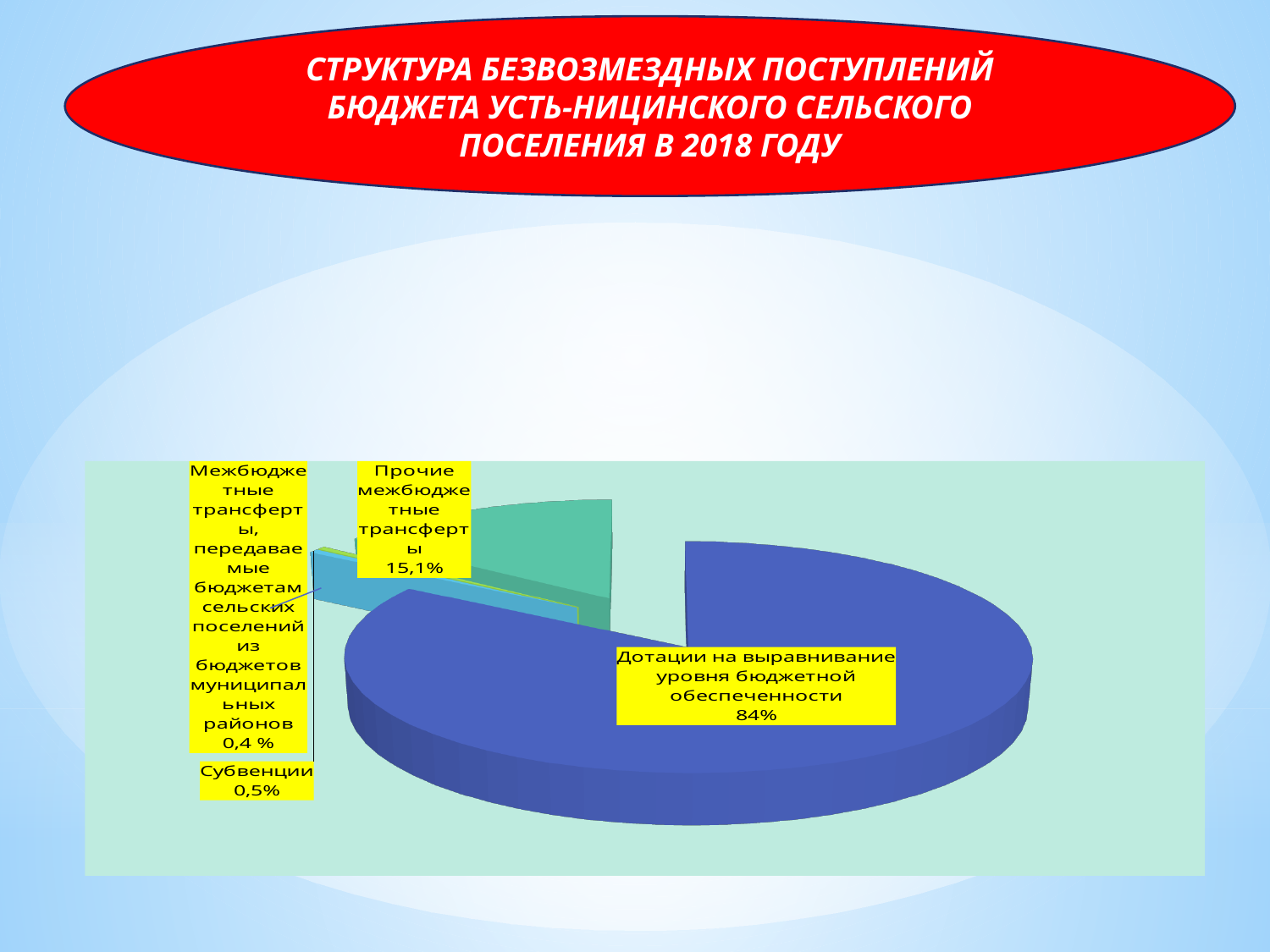
What kind of chart is shown on the slide? pie chart How many slices does the pie chart have? 4 What share of the pie is labelled "Субвенции"? 0,5% What is the difference in percentage points between "Дотации на выравнивание уровня бюджетной обеспеченности" and "Прочие межбюджетные трансферты"? 68,9 What share of the pie is labelled "Дотации на выравнивание уровня бюджетной обеспеченности"? 84% What year does the chart title refer to? 2018 Which slice of the pie is the largest? Дотации на выравнивание уровня бюджетной обеспеченности What share of the pie is labelled "Межбюджетные трансферты, передаваемые бюджетам сельских поселений из бюджетов муниципальных районов"? 0,4 % Which is larger, the share for "Субвенции" or the share for "Прочие межбюджетные трансферты"? Прочие межбюджетные трансферты What colour is the largest slice of the pie? blue What share of the pie is labelled "Прочие межбюджетные трансферты"? 15,1% Which slice of the pie is the smallest? Межбюджетные трансферты, передаваемые бюджетам сельских поселений из бюджетов муниципальных районов